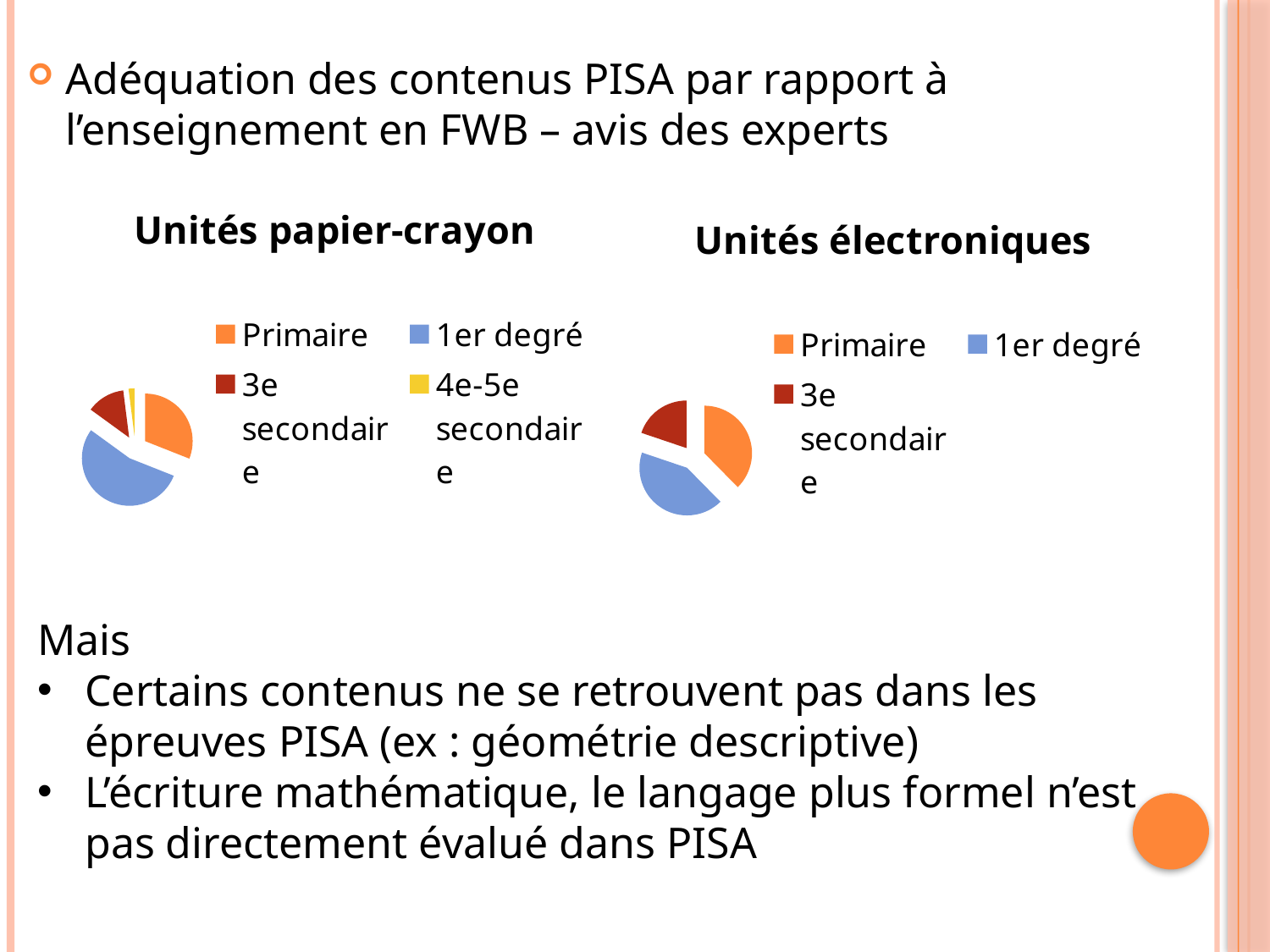
In the 'Unités électroniques' chart, which category has the largest slice? 1er degré In the 'Unités papier-crayon' chart, which category has the smallest slice? 4e-5e secondaire What kind of chart is the 'Unités papier-crayon' chart? pie chart In the 'Unités électroniques' chart, which slice is larger: Primaire or 3e secondaire? Primaire What kind of chart is the 'Unités électroniques' chart? pie chart What colour represents '1er degré' in both pie charts? blue In the 'Unités papier-crayon' chart, which category has the largest slice? 1er degré In the 'Unités électroniques' chart, which category has the smallest slice? 3e secondaire In the 'Unités papier-crayon' chart, which slice is larger: Primaire or 3e secondaire? Primaire How many categories does the legend of the 'Unités électroniques' chart list? 3 Which category appears in the legend of the 'Unités papier-crayon' chart but not in the legend of the 'Unités électroniques' chart? 4e-5e secondaire How many categories does the legend of the 'Unités papier-crayon' chart list? 4